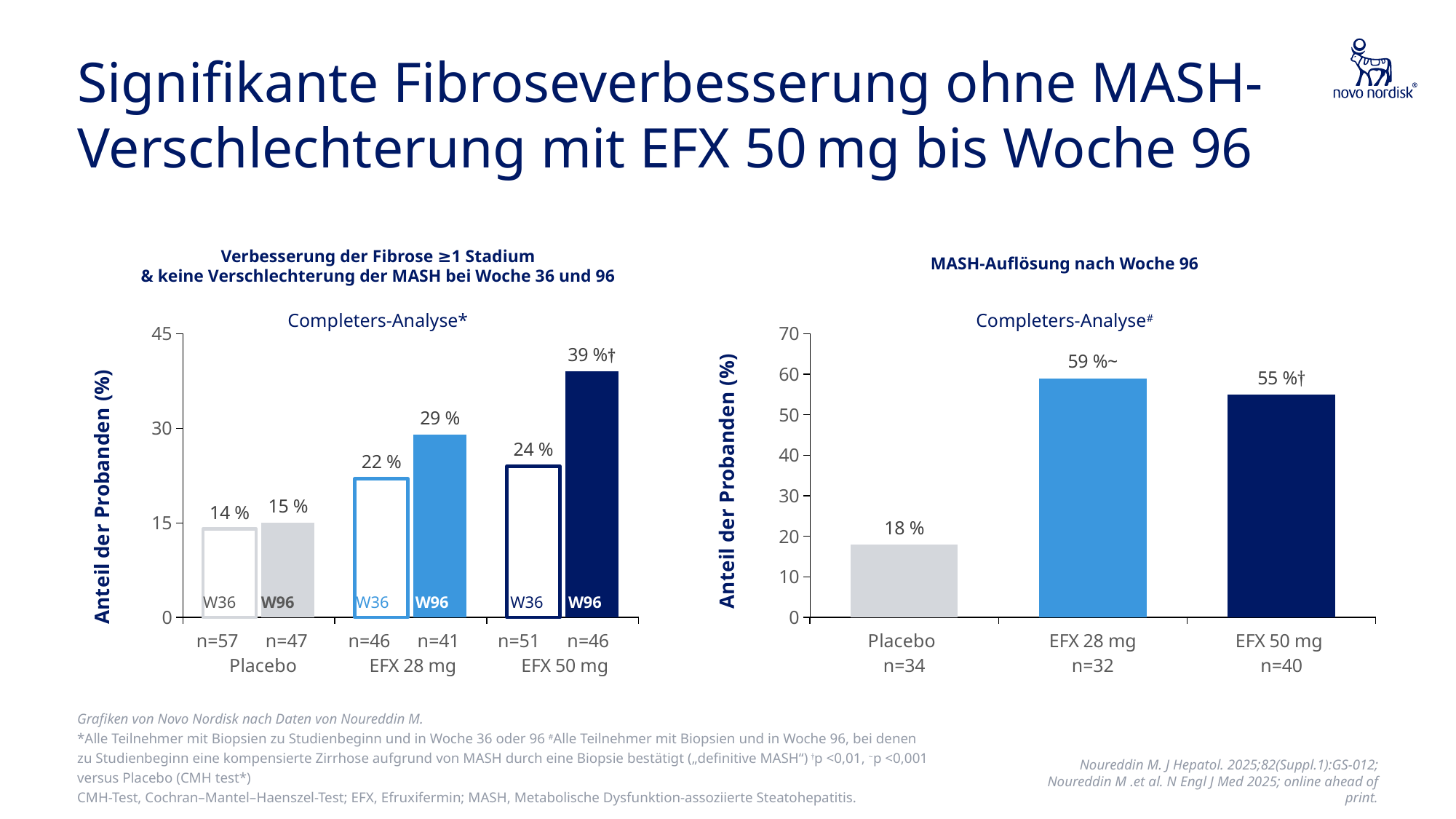
In the left chart (Verbesserung der Fibrose ≥1 Stadium), what is the W36 value for EFX 28 mg? 22 % In the right chart (MASH-Auflösung nach Woche 96), how many groups are shown? 3 In the right chart (MASH-Auflösung nach Woche 96), is the value for EFX 50 mg greater or less than 50? greater In the right chart (MASH-Auflösung nach Woche 96), what is the value for Placebo? 18 % In the left chart (Verbesserung der Fibrose ≥1 Stadium), which treatment group has the highest W96 value? EFX 50 mg In the left chart (Verbesserung der Fibrose ≥1 Stadium), which treatment group has the lowest W36 value? Placebo In the left chart (Verbesserung der Fibrose ≥1 Stadium), what is the W96 value for EFX 50 mg? 39 % In the right chart (MASH-Auflösung nach Woche 96), which group has the highest value? EFX 28 mg In the left chart (Verbesserung der Fibrose ≥1 Stadium), what is the W96 value for Placebo? 15 % In the right chart (MASH-Auflösung nach Woche 96), what is the difference between EFX 28 mg and EFX 50 mg? 4 % In the left chart (Verbesserung der Fibrose ≥1 Stadium), what is the difference between the W96 and W36 values for EFX 50 mg? 15 % What kind of chart is the right chart (MASH-Auflösung nach Woche 96)? Bar chart